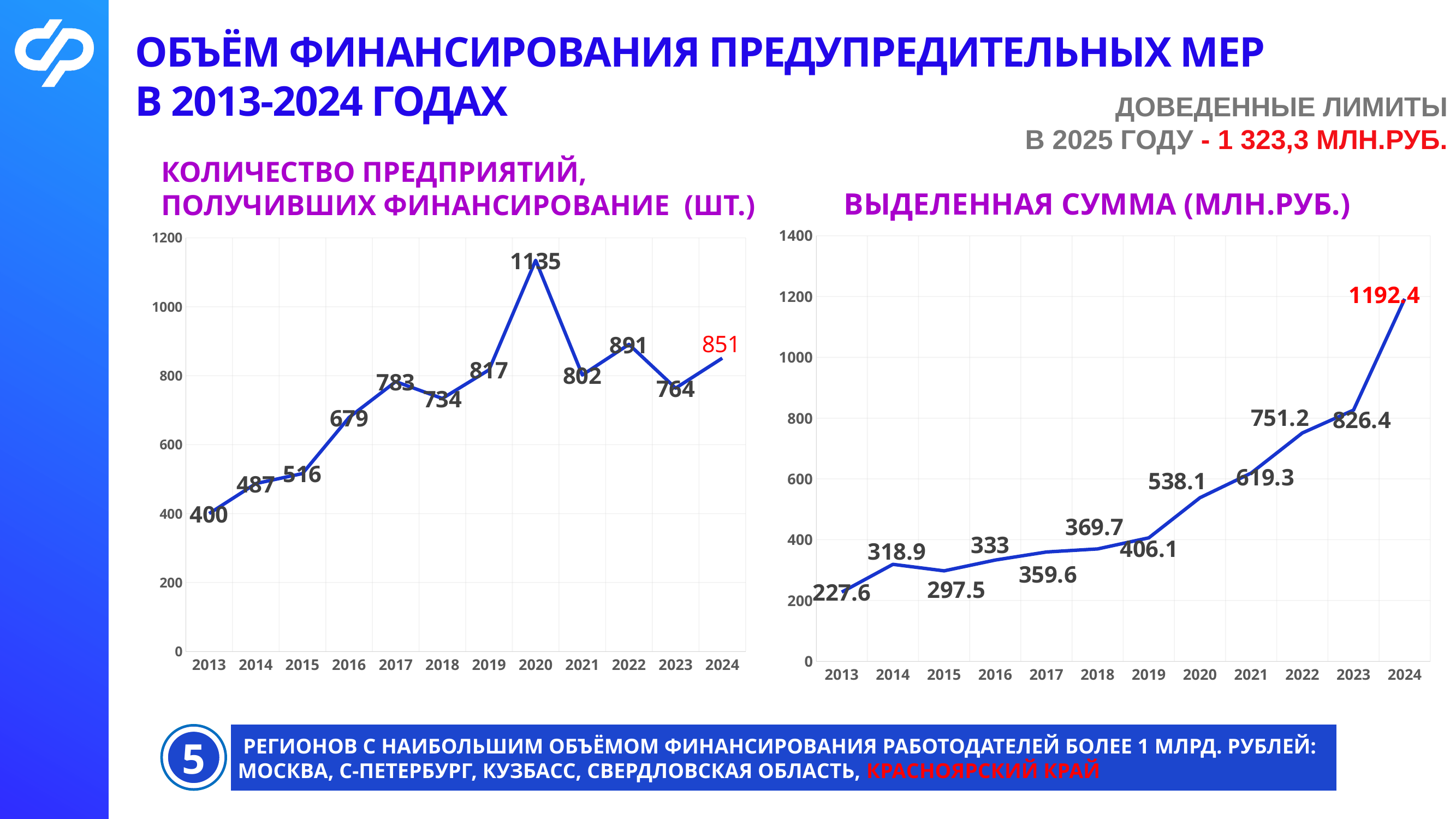
How many years are plotted in the right chart (allocated sum, mln rub.)? 12 In the right chart (allocated sum, mln rub.), what is the value for 2019? 406.1 In the right chart (allocated sum, mln rub.), which year has the lowest value? 2013 What type of chart is the left chart (number of enterprises that received financing)? Line chart In the right chart (allocated sum, mln rub.), what is the difference between the 2024 value and the 2023 value? 366 In the right chart (allocated sum, mln rub.), which is larger: the value for 2014 or the value for 2015? 2014 In the right chart (allocated sum, mln rub.), what is the value for 2024? 1192.4 In the left chart (number of enterprises that received financing), what is the value for 2020? 1135 In the left chart (number of enterprises that received financing), which year has the highest value? 2020 In the left chart (number of enterprises that received financing), what is the value for 2024? 851 In the left chart (number of enterprises that received financing), which year has the lowest value? 2013 In the left chart (number of enterprises that received financing), what is the difference between the 2020 value and the 2021 value? 333